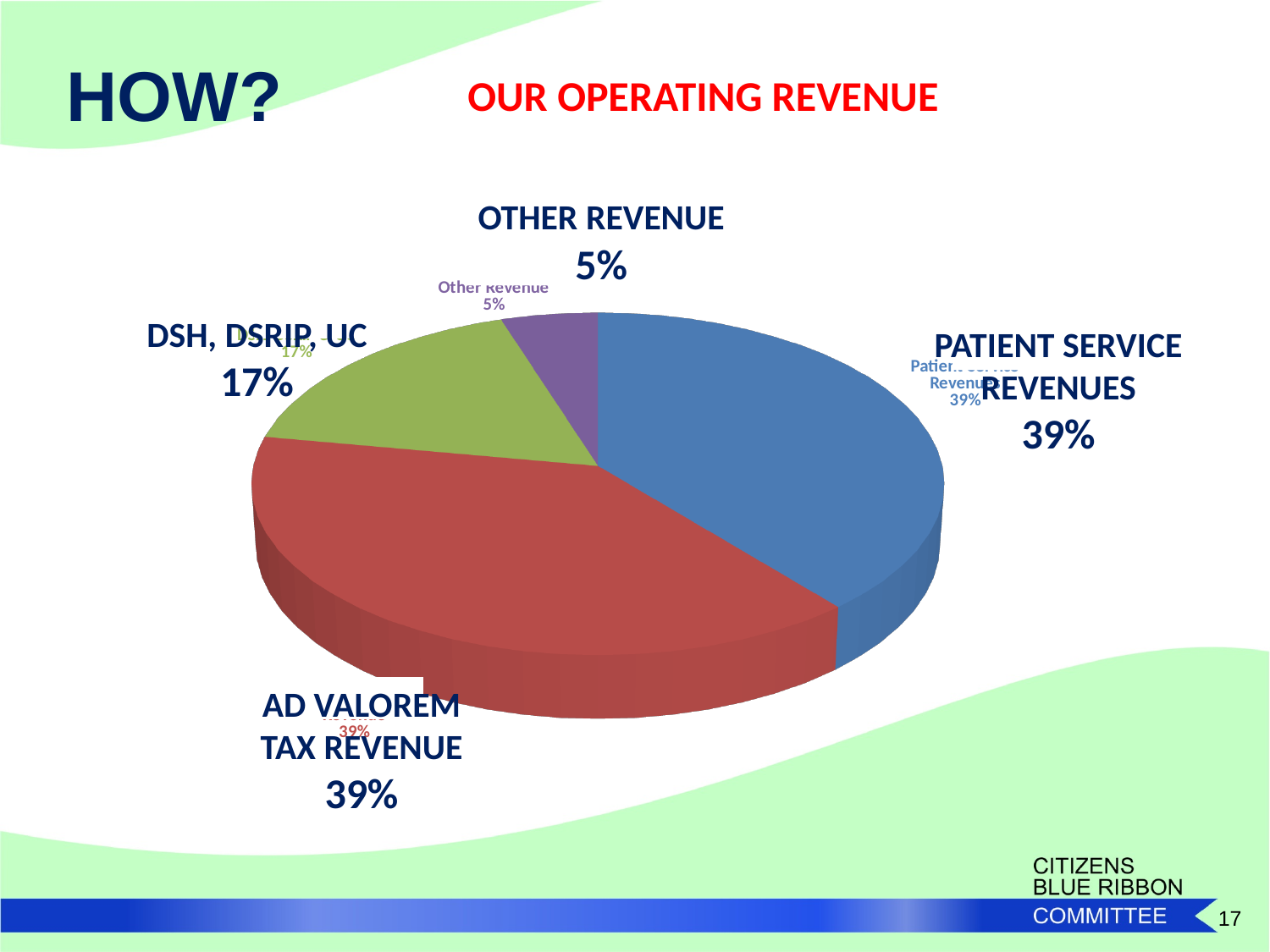
What is the title of the chart? OUR OPERATING REVENUE How many percentage points larger is Patient Service Revenues than DSH, DSRIP, UC? 22% What is the difference between DSH, DSRIP, UC and Other Revenue? 12% What share of the pie does Other Revenue represent? 5% What share of operating revenue comes from Patient Service Revenues? 39% Which is larger, DSH, DSRIP, UC or Other Revenue? DSH, DSRIP, UC What do Patient Service Revenues and Ad Valorem Tax Revenue add up to together? 78% Which category has the smallest slice of the pie? Other Revenue What percentage of the pie is Ad Valorem Tax Revenue? 39% What is the value shown for DSH, DSRIP, UC? 17% How many categories are shown in the pie chart? 4 What kind of chart is shown on the slide? Pie chart